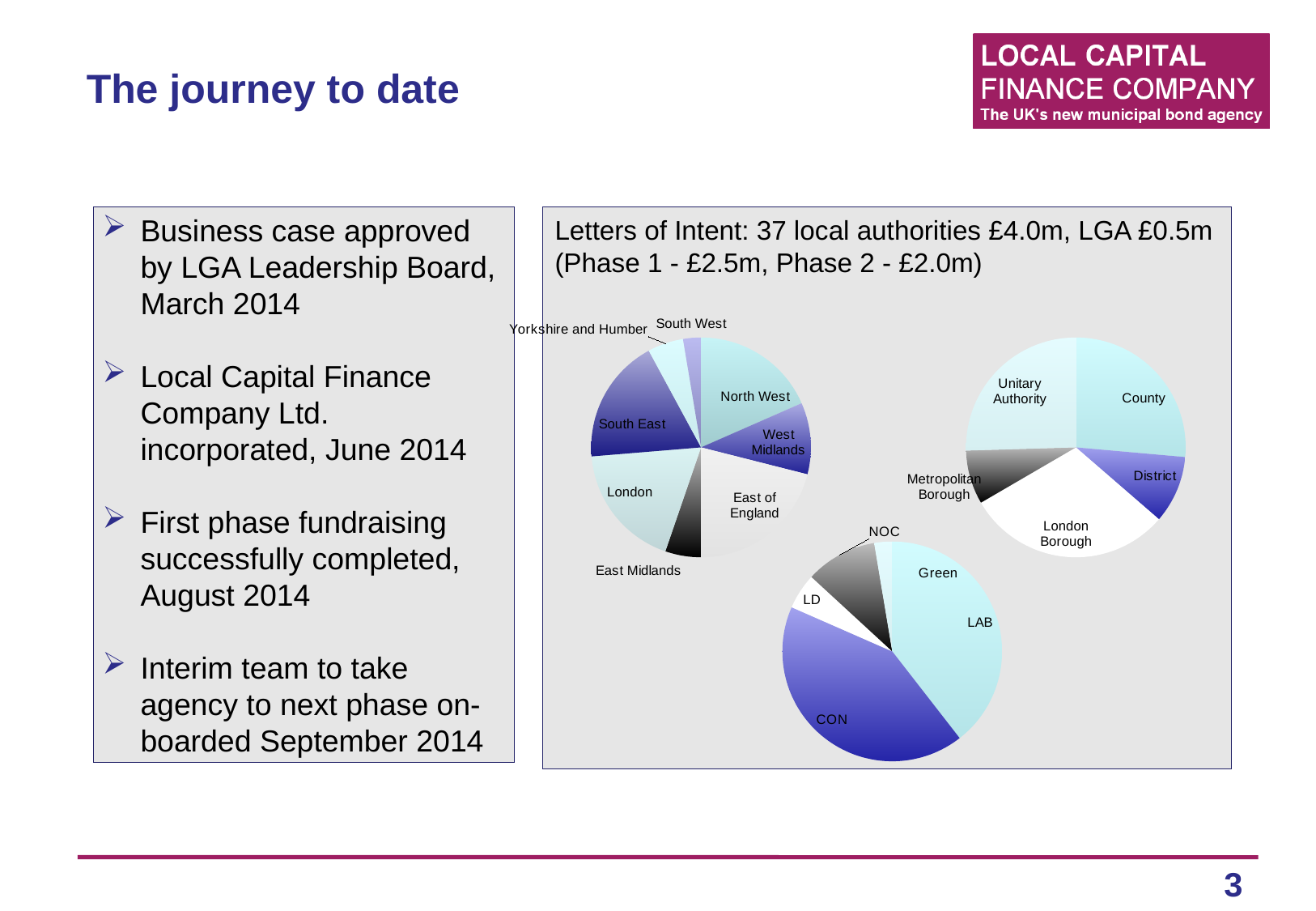
In the top-left pie chart showing English regions, which slice is the smallest? South West What kind of chart is the chart on the bottom of the right-hand panel, with slices labelled CON, LAB, LD, NOC and Green? pie chart In the right-hand pie chart showing authority types, which slice is larger, County or District? County In the pie chart with slices labelled CON, LAB, LD, NOC and Green, which slice is larger, LAB or LD? LAB In the pie chart with slices labelled CON, LAB, LD, NOC and Green, which slice is the smallest? Green In the pie chart with slices labelled CON, LAB, LD, NOC and Green, which slice is the largest? CON According to the heading above the pie charts, how many local authorities provided Letters of Intent? 37 How many pie charts are shown on the slide? 3 How many slices does the right-hand pie chart showing authority types (County, District, London Borough, etc.) have? 5 How many slices does the pie chart with slices labelled CON, LAB, LD, NOC and Green have? 5 In the pie chart with slices labelled CON, LAB, LD, NOC and Green, which slice is larger, CON or LAB? CON